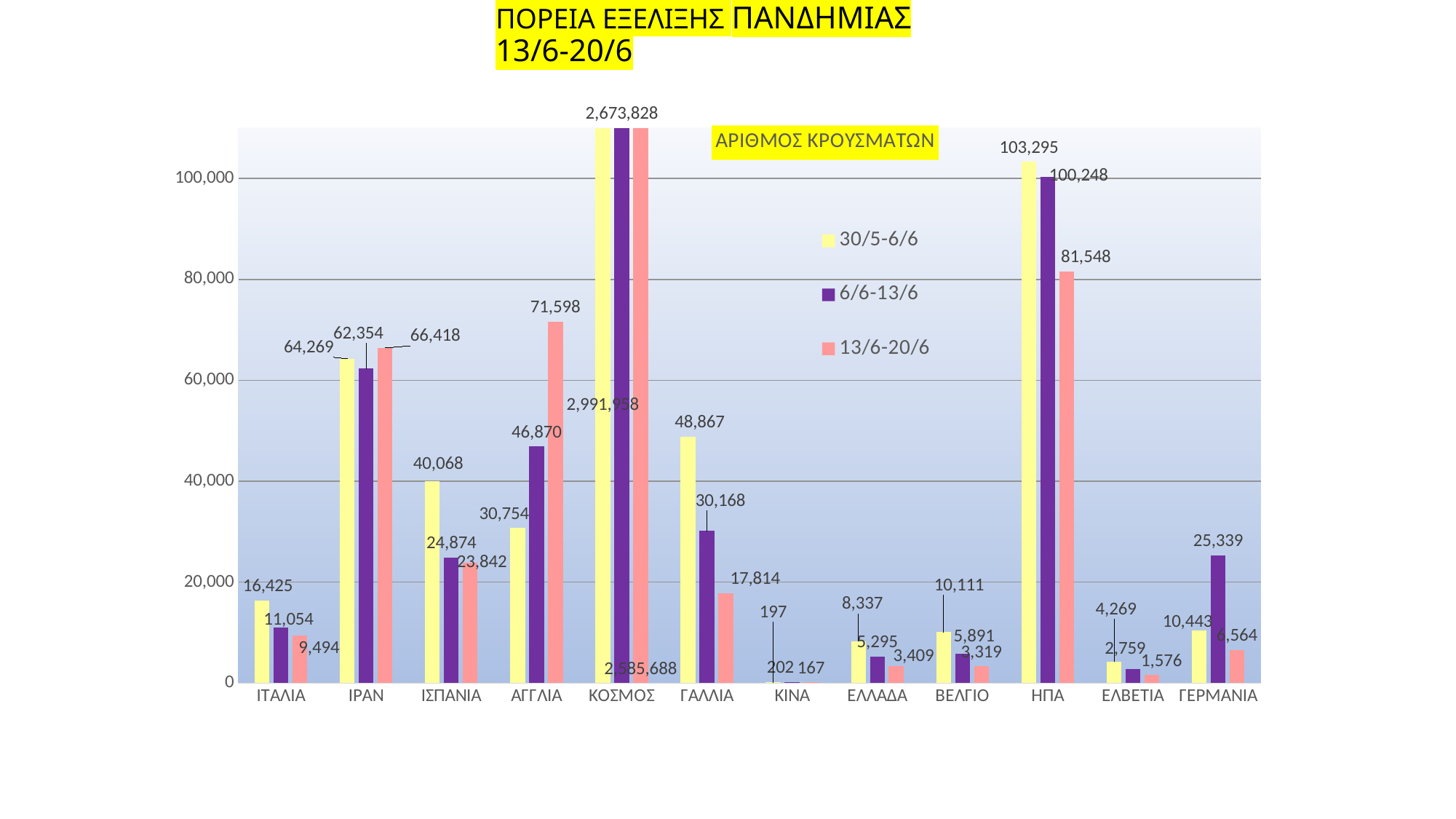
Which category has the lowest value in the 13/6-20/6 series? ΚΙΝΑ Do the values for ΓΑΛΛΙΑ rise or fall across the three periods from 30/5-6/6 to 13/6-20/6? fall How many countries/categories are shown on the x axis? 12 Is the 13/6-20/6 value for ΑΓΓΛΙΑ greater or less than 60,000? greater What is the difference between the 30/5-6/6 and 13/6-20/6 values for ΙΤΑΛΙΑ? 6,931 What type of chart is shown on the slide? bar chart What is the value for ΕΛΛΑΔΑ in the 30/5-6/6 series? 8,337 Which category has the highest values overall? ΚΟΣΜΟΣ What is the value for ΗΠΑ in the 13/6-20/6 series? 81,548 How many series does the legend list? 3 What is the value for ΑΓΓΛΙΑ in the 6/6-13/6 series? 46,870 Which is larger for ΓΕΡΜΑΝΙΑ: the 6/6-13/6 value or the 30/5-6/6 value? 6/6-13/6